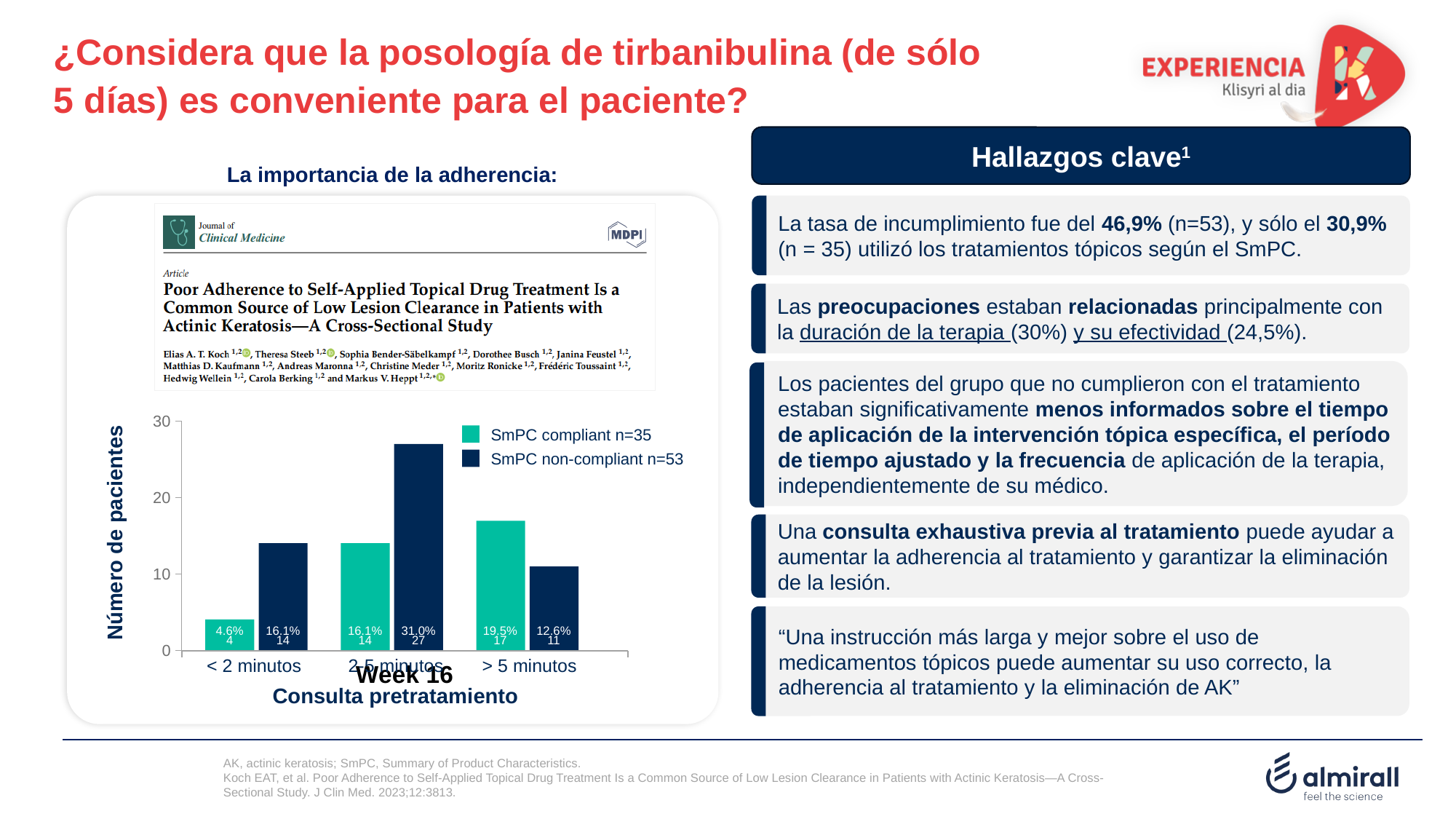
Which category has the lowest number of SmPC compliant patients? < 2 minutos What percentage is shown for SmPC non-compliant in the middle category of the chart? 31.0% What is the number of patients for SmPC compliant in the '> 5 minutos' category? 17 Which category has the highest number of SmPC non-compliant patients? 2-5 minutos (middle category) In the '> 5 minutos' category, which series has more patients, SmPC compliant or SmPC non-compliant? SmPC compliant How many categories are shown on the x axis of the chart? 3 What is the number of patients for SmPC compliant in the '< 2 minutos' category? 4 What percentage is shown for SmPC non-compliant in the '> 5 minutos' category? 12.6% What is the difference in number of patients between SmPC non-compliant and SmPC compliant in the middle category? 13 What kind of chart is shown on the slide? bar chart How many series does the chart legend list? 2 What is the number of patients for SmPC non-compliant in the '< 2 minutos' category? 14